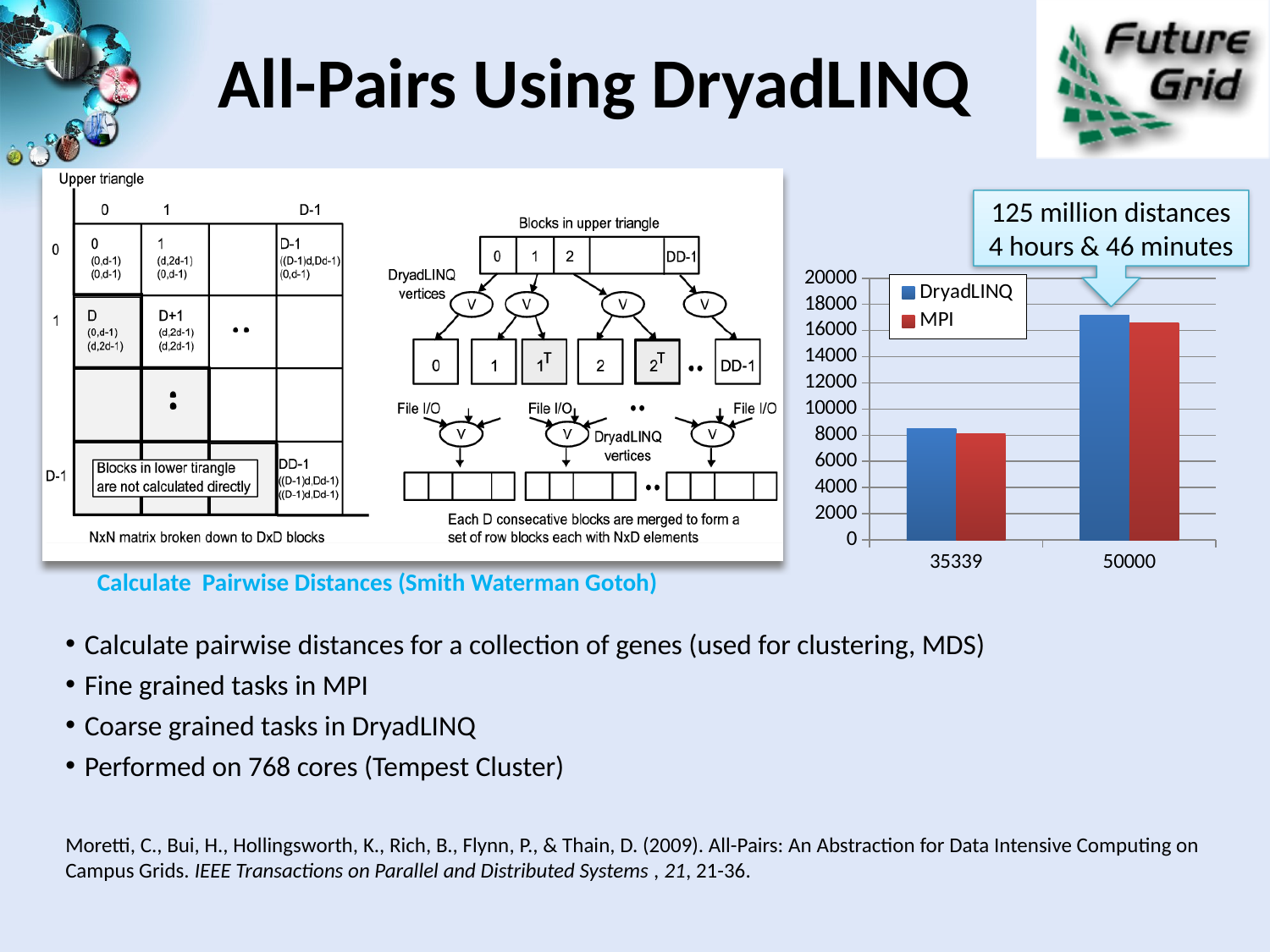
How many categories are shown on the x axis of the bar chart? 2 Which category on the x axis has the shortest bars in the bar chart? 35339 Is the MPI value for 50000 greater or less than 18000? less What kind of chart is shown on the right of the slide? bar chart Do the bar values rise or fall from 35339 to 50000 along the x axis? rise How many series does the legend of the bar chart list? 2 Is the DryadLINQ value for 50000 greater or less than 16000? greater Is the MPI value for 35339 greater or less than 10000? less Which category on the x axis has the tallest bars in the bar chart? 50000 What are the two series named in the bar chart legend? DryadLINQ and MPI What colour are the DryadLINQ bars in the chart? blue